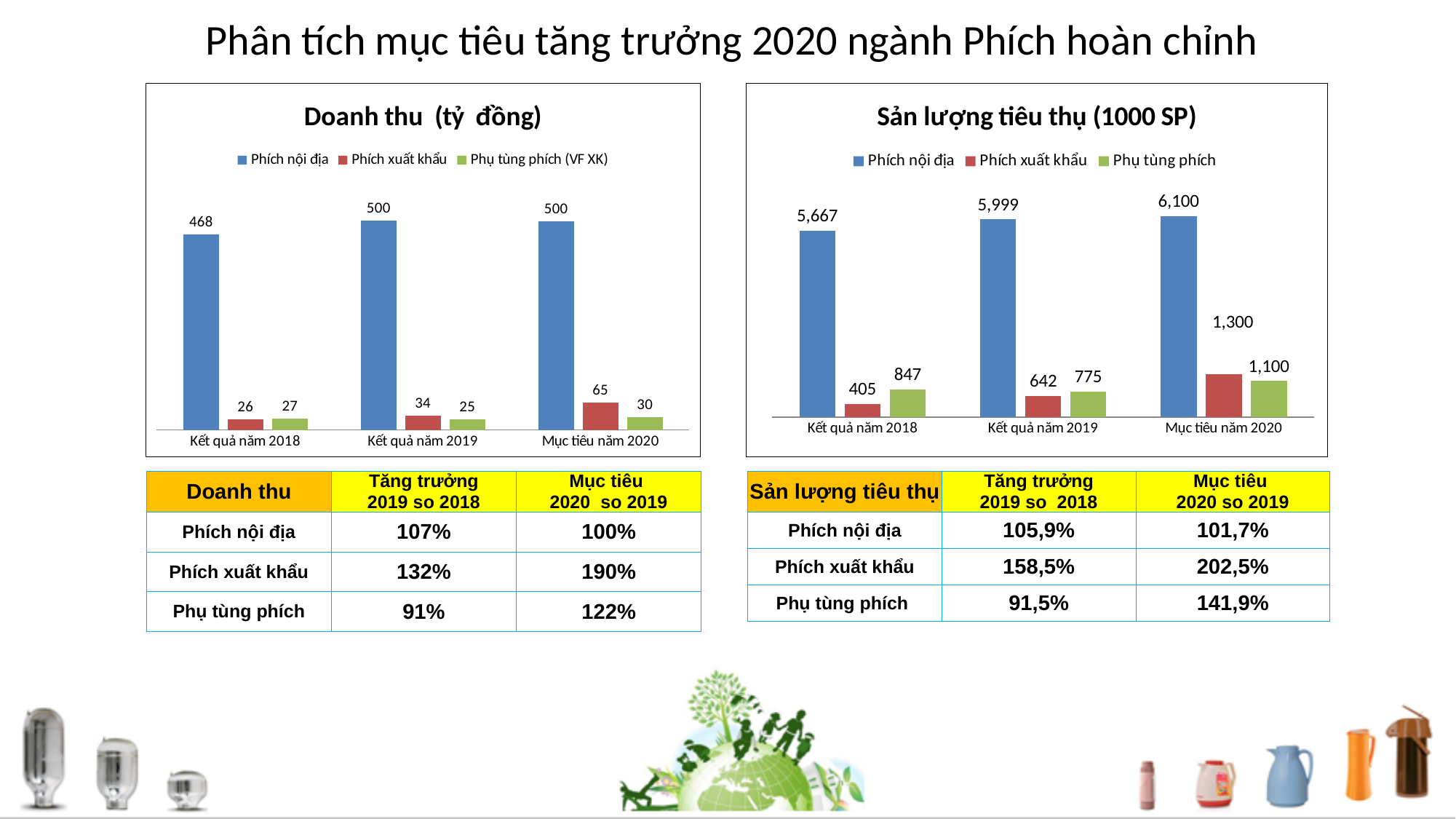
In the 'Doanh thu (tỷ đồng)' chart, what is the value for Phích nội địa in Kết quả năm 2018? 468 In the 'Sản lượng tiêu thụ (1000 SP)' chart, does the value for Phích nội địa rise or fall from Kết quả năm 2018 to Mục tiêu năm 2020? rise In the 'Doanh thu (tỷ đồng)' chart, what is the difference between Phích xuất khẩu in Mục tiêu năm 2020 and in Kết quả năm 2019? 31 In the 'Sản lượng tiêu thụ (1000 SP)' chart, which is larger in Kết quả năm 2019: Phích xuất khẩu or Phụ tùng phích? Phụ tùng phích In the 'Sản lượng tiêu thụ (1000 SP)' chart, what is the difference between Phích xuất khẩu in Kết quả năm 2019 and in Kết quả năm 2018? 237 In the 'Sản lượng tiêu thụ (1000 SP)' chart, what is the value for Phích nội địa in Mục tiêu năm 2020? 6,100 In the 'Doanh thu (tỷ đồng)' chart, what is the value for Phích xuất khẩu in Mục tiêu năm 2020? 65 In the 'Doanh thu (tỷ đồng)' chart, which category has the lowest value for Phụ tùng phích (VF XK)? Kết quả năm 2019 What kind of chart is the 'Sản lượng tiêu thụ (1000 SP)' chart? bar chart In the 'Sản lượng tiêu thụ (1000 SP)' chart, what is the value for Phụ tùng phích in Kết quả năm 2018? 847 In the 'Doanh thu (tỷ đồng)' chart, how many series does the legend list? 3 In the 'Sản lượng tiêu thụ (1000 SP)' chart, which category has the highest value for Phích xuất khẩu? Mục tiêu năm 2020